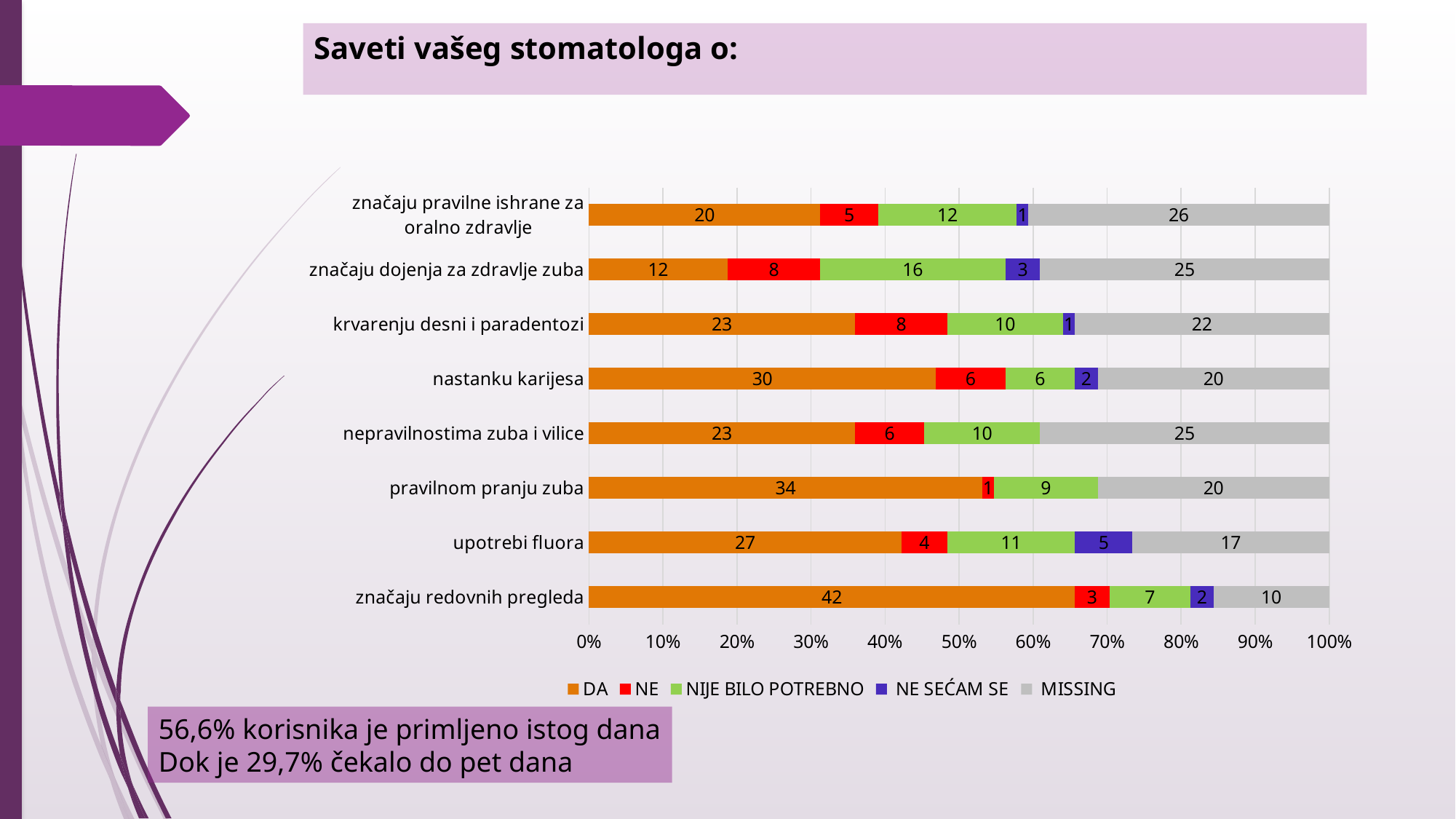
What is the title of the chart? Saveti vašeg stomatologa o: What is the MISSING value for 'značaju pravilne ishrane za oralno zdravlje'? 26 How many categories are shown on the chart? 8 What is the difference between the DA values for 'pravilnom pranju zuba' and 'upotrebi fluora'? 7 Which category has the highest DA value? značaju redovnih pregleda What type of chart is shown on the slide? stacked bar chart Which category has the lowest DA value? značaju dojenja za zdravlje zuba What is the NIJE BILO POTREBNO value for 'značaju dojenja za zdravlje zuba'? 16 How many series does the legend list? 5 What is the total of all segments in the bar for 'upotrebi fluora'? 64 What is the DA value for 'značaju redovnih pregleda'? 42 Which is larger: the NE value for 'krvarenju desni i paradentozi' or the NE value for 'nastanku karijesa'? krvarenju desni i paradentozi